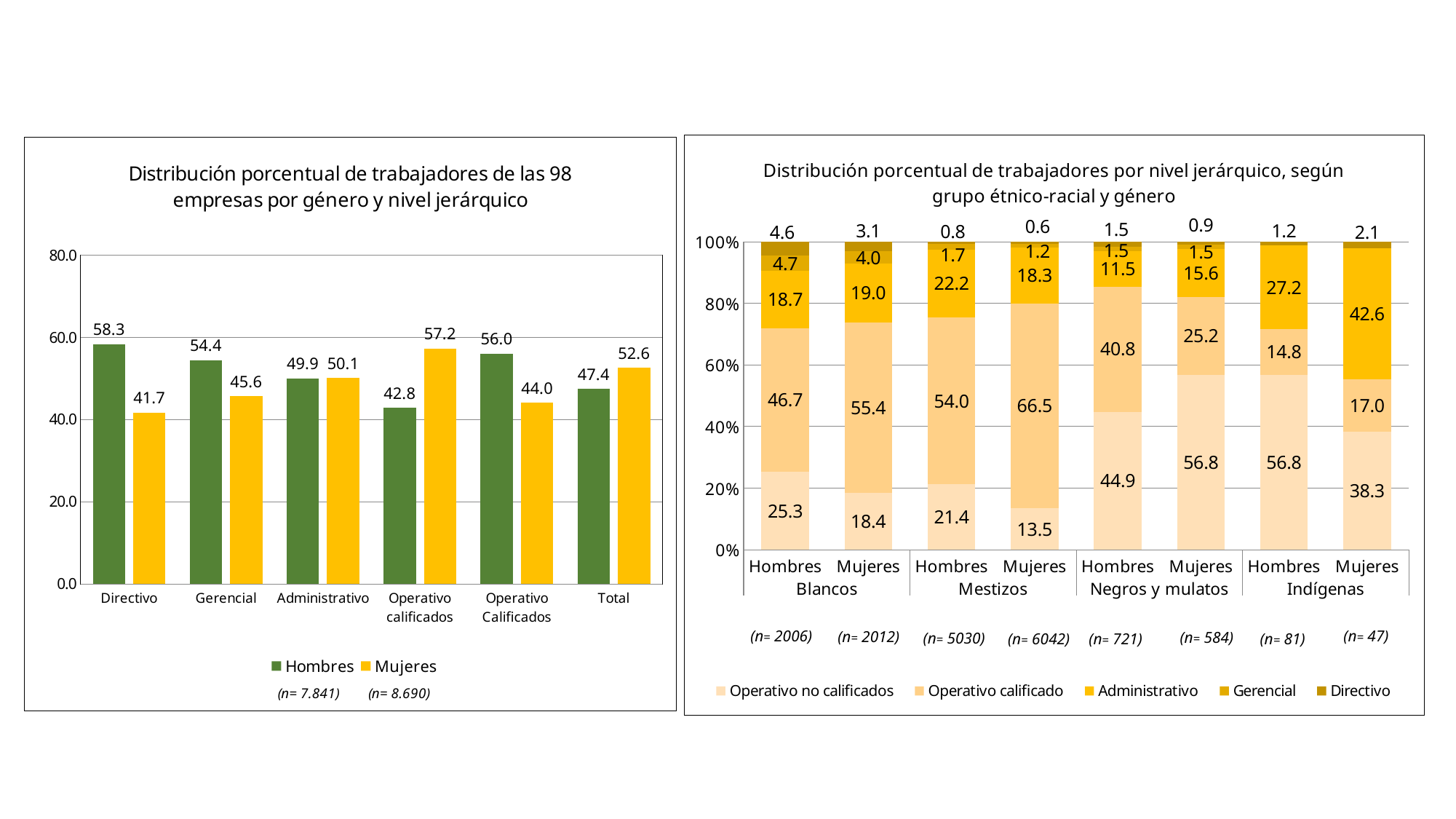
In the right chart, how many bars are plotted? 8 In the left chart (Distribución porcentual de trabajadores de las 98 empresas por género y nivel jerárquico), what is the value for Hombres in the Directivo category? 58.3 In the left chart, which category has the highest value for Mujeres? Operativo calificados In the right chart, how many series does the legend list? 5 In the left chart, what is the value for Mujeres in the Total category? 52.6 What kind of chart is the left chart? Bar chart In the left chart, which category has the lowest value for Hombres? Operativo calificados In the left chart, what is the difference between the Hombres and Mujeres values in the Gerencial category? 8.8 In the right chart (Distribución porcentual de trabajadores por nivel jerárquico, según grupo étnico-racial y género), what is the Operativo no calificados value for Mujeres Indígenas? 38.3 In the left chart, which is larger in the Administrativo category, Hombres or Mujeres? Mujeres In the left chart, how many series does the legend list? 2 In the right chart, what is the Administrativo value for Mujeres Negros y mulatos? 15.6